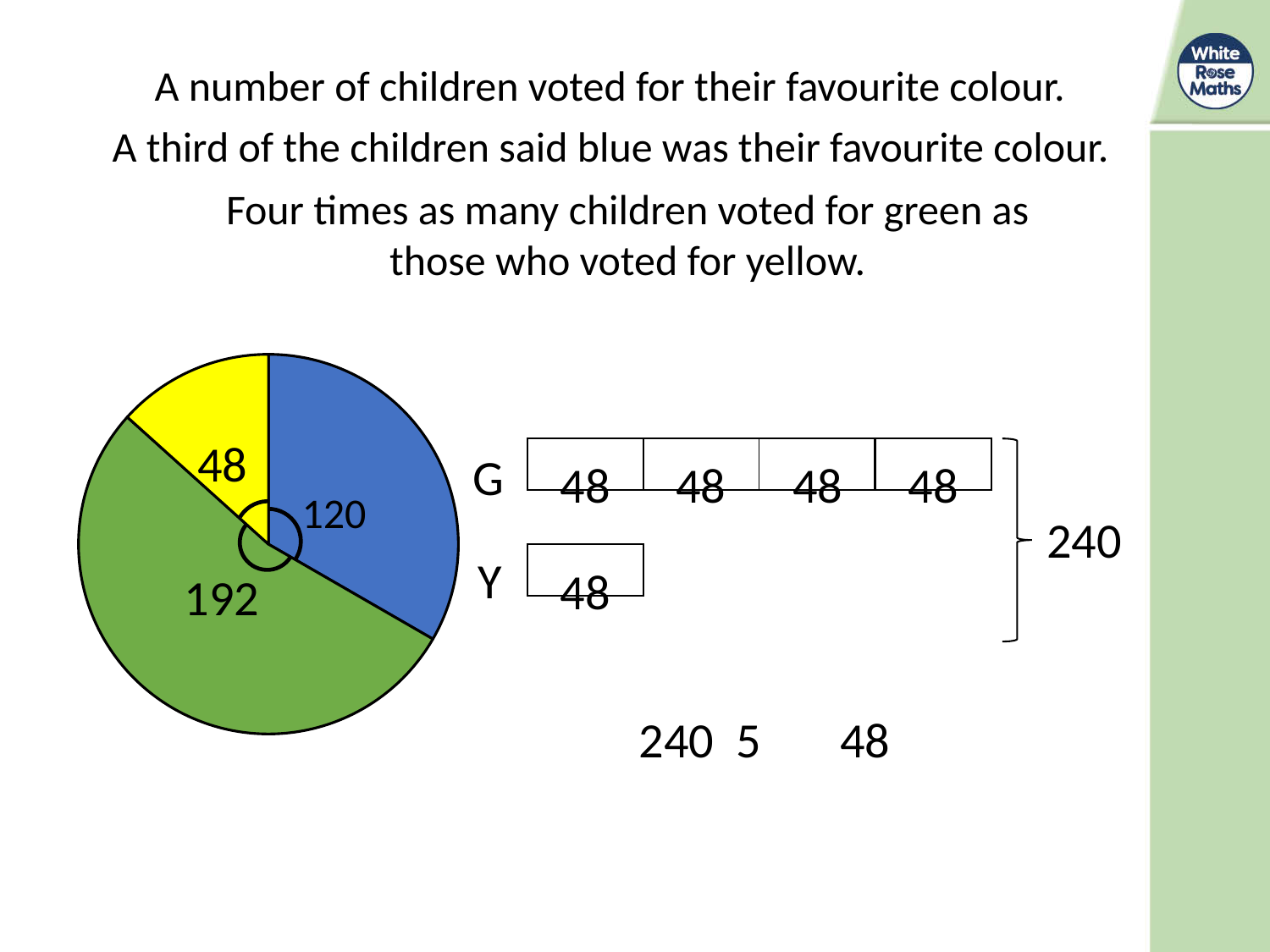
In the pie chart, what is the difference between the green value and the blue value? 72 What kind of chart is shown on the left of the slide? pie chart In the pie chart, what is the difference between the green value and the yellow value? 144 How many slices does the pie chart have? 3 What value is labelled on the blue slice of the pie chart? 120 What value is labelled on the yellow slice of the pie chart? 48 In the pie chart, which is larger, the blue value or the yellow value? blue In the bar model on the right, what total is shown by the bracket for G and Y together? 240 In the bar model on the right, what is the total of the four boxes in the G bar? 192 Which slice of the pie chart has the smallest value? yellow Which slice of the pie chart has the largest value? green What value is labelled on the green slice of the pie chart? 192